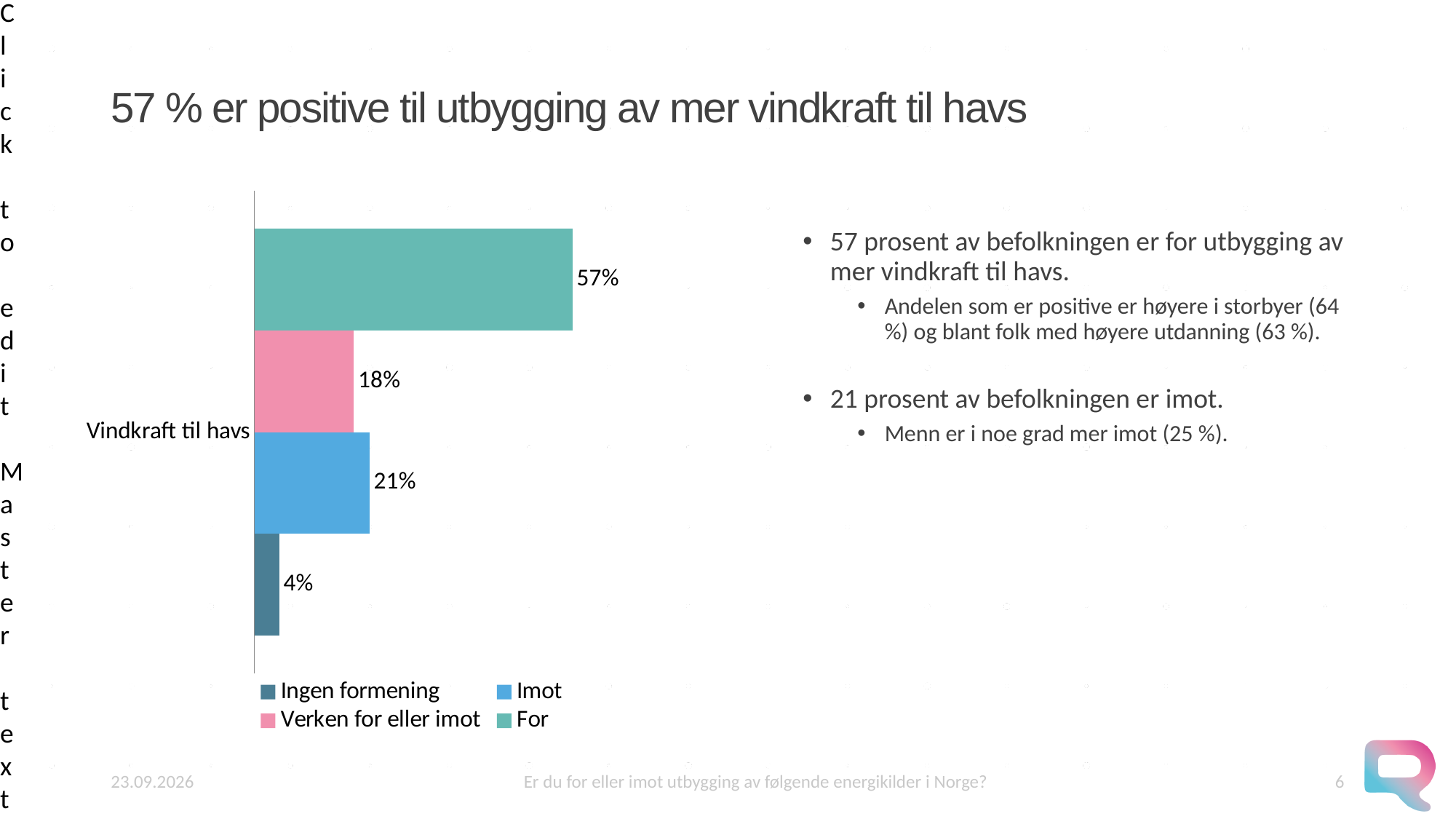
What kind of chart is shown on the slide? Bar chart What is the category label shown on the chart's axis? Vindkraft til havs What is the value for the 'Ingen formening' series for Vindkraft til havs? 4% What is the difference between the 'Imot' and 'Verken for eller imot' values? 3% What is the value for the 'For' series for Vindkraft til havs? 57% What is the value for the 'Imot' series for Vindkraft til havs? 21% How many series does the legend list? 4 Which series has the highest value for Vindkraft til havs? For Which series has the lowest value for Vindkraft til havs? Ingen formening Which is larger for Vindkraft til havs: 'Imot' or 'Verken for eller imot'? Imot What is the difference between the 'For' and 'Imot' values for Vindkraft til havs? 36% What is the value for the 'Verken for eller imot' series for Vindkraft til havs? 18%